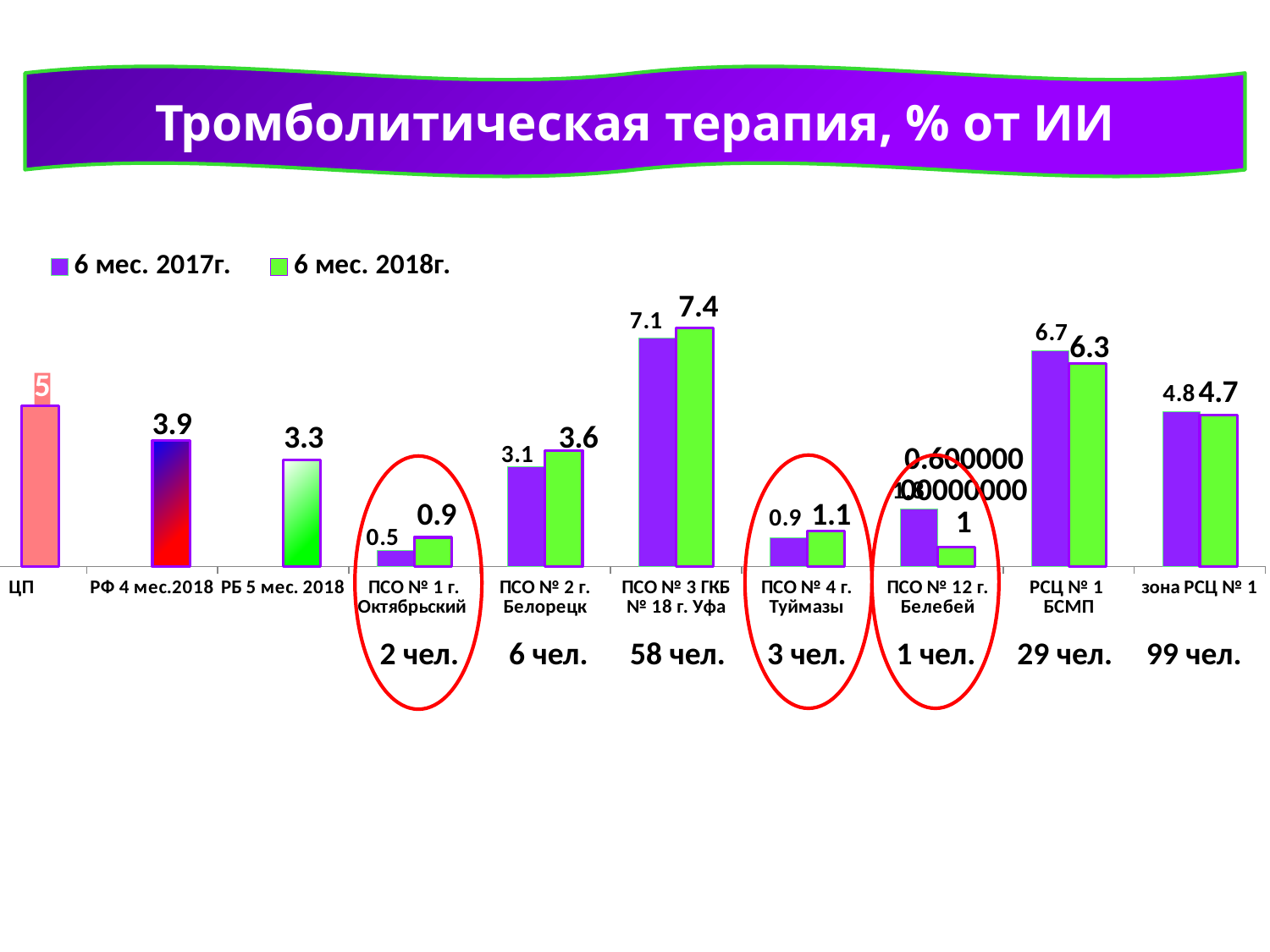
For РСЦ № 1 БСМП, which is larger: the 6 мес. 2017г. value or the 6 мес. 2018г. value? 6 мес. 2017г. How many series does the legend list? 2 What is the value for 6 мес. 2018г. for ПСО № 1 г. Октябрьский? 0.9 What is the value shown for РФ 4 мес.2018? 3.9 What is the value for 6 мес. 2018г. for ПСО № 3 ГКБ № 18 г. Уфа? 7.4 What is the value for 6 мес. 2017г. for ПСО № 2 г. Белорецк? 3.1 Which category has the lowest value for 6 мес. 2017г.? ПСО № 1 г. Октябрьский What kind of chart is shown on the slide? Bar chart What is the title of the chart? Тромболитическая терапия, % от ИИ What is the difference between the 6 мес. 2018г. and 6 мес. 2017г. values for ПСО № 2 г. Белорецк? 0.5 How many categories are shown on the x axis? 10 Which category has the highest value for 6 мес. 2017г.? ПСО № 3 ГКБ № 18 г. Уфа